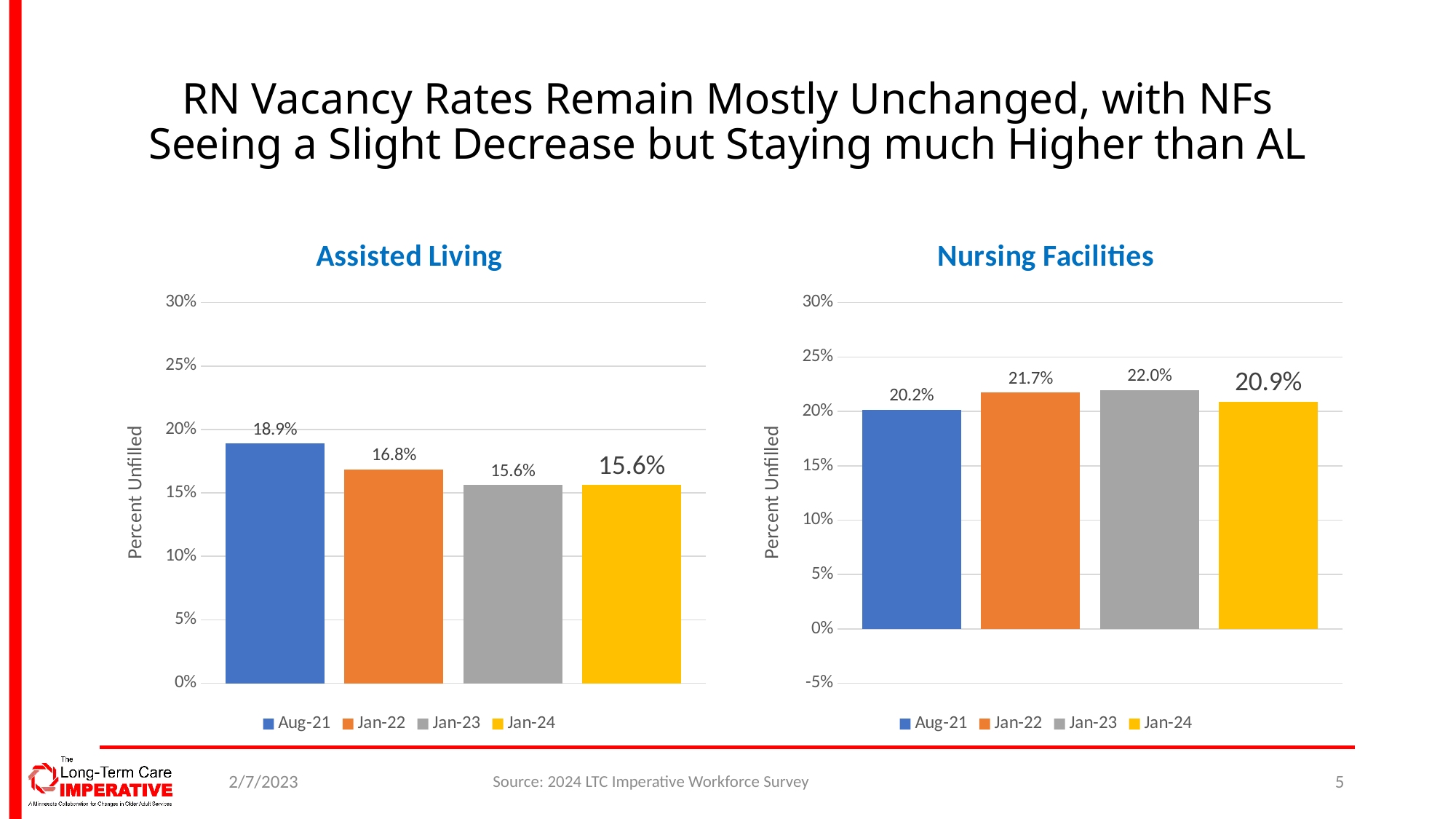
In the Nursing Facilities chart, what is the value for Jan-24? 20.9% How many bars are plotted in the Assisted Living chart? 4 In the Nursing Facilities chart, is the value for Jan-22 greater or less than 20%? greater How many series does the legend of the Nursing Facilities chart list? 4 In the Assisted Living chart, what is the difference between the Aug-21 and Jan-22 values? 2.1% In the Nursing Facilities chart, which period has the lowest value? Aug-21 In the Assisted Living chart, what is the value for Aug-21? 18.9% In the Nursing Facilities chart, what is the value for Jan-23? 22.0% In the Nursing Facilities chart, what is the difference between the Jan-23 and Jan-24 values? 1.1% What kind of chart is the Assisted Living chart? Bar chart In the Assisted Living chart, which period has the highest value? Aug-21 Which is larger: the Jan-24 value in the Assisted Living chart or the Jan-24 value in the Nursing Facilities chart? Nursing Facilities